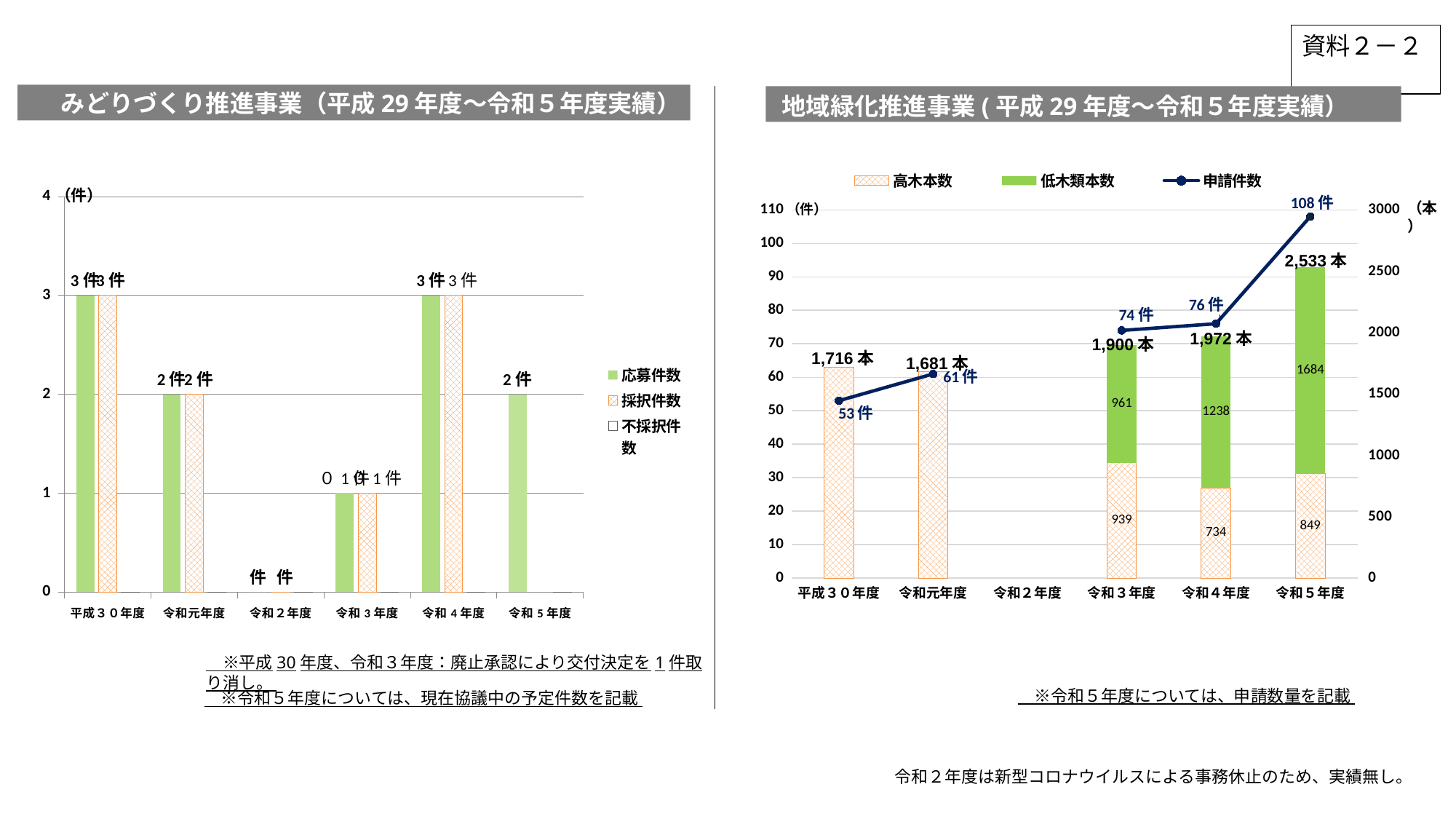
In the right chart (地域緑化推進事業), what is the difference in 申請件数 between 令和５年度 and 令和４年度? 32件 In the right chart (地域緑化推進事業), which year has the highest 申請件数? 令和５年度 In the right chart (地域緑化推進事業), what is the 申請件数 for 令和５年度? 108件 In the left chart (みどりづくり推進事業), is the 応募件数 for 令和元年度 larger or smaller than that for 令和４年度? smaller In the right chart (地域緑化推進事業), how many series does the legend list? 3 In the right chart (地域緑化推進事業), what is the total number of trees (本) for 令和３年度? 1,900本 In the left chart (みどりづくり推進事業), what is the 採択件数 for 平成３０年度? 3件 In the right chart (地域緑化推進事業), which year has the lowest 申請件数? 平成３０年度 What kind of chart is the left chart (みどりづくり推進事業)? bar chart In the right chart (地域緑化推進事業), what is the 高木本数 for 令和５年度? 849 In the right chart (地域緑化推進事業), what is the 低木類本数 for 令和４年度? 1238 In the left chart (みどりづくり推進事業), what is the 応募件数 for 令和５年度? 2件